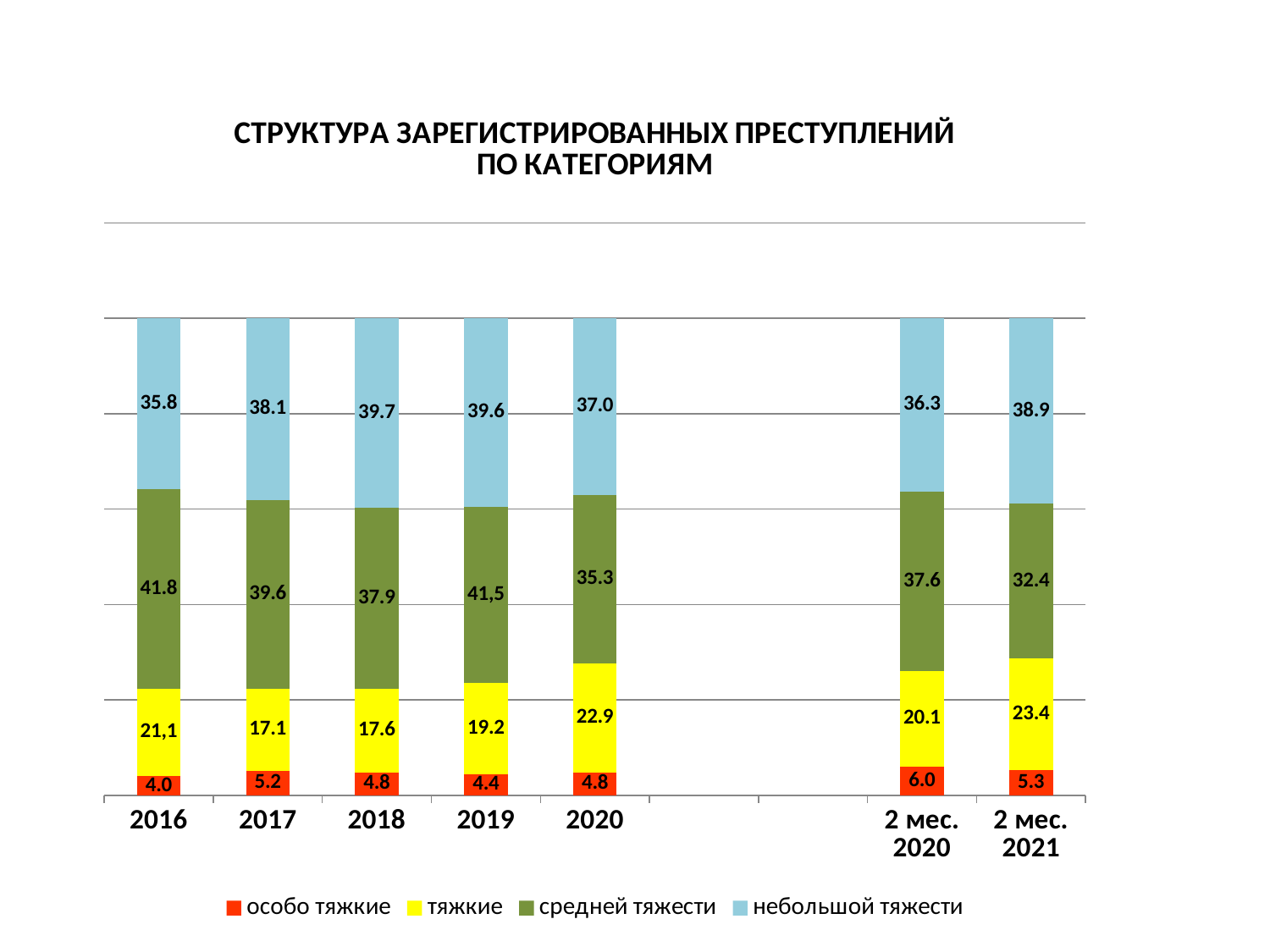
What is the value for тяжкие in 2020? 22.9 What is the value for средней тяжести in 2019? 41,5 In which category is the value for особо тяжкие highest? 2 мес. 2020 Do the values for тяжкие rise or fall from 2017 to 2020? Rise Which is larger, the особо тяжкие value for 2017 or for 2019? 2017 What is the value for небольшой тяжести in 2 мес. 2021? 38.9 How many series does the legend list? 4 How many categories are shown on the x axis? 7 What kind of chart is shown on the slide? Stacked bar chart What is the difference between the тяжкие values for 2020 and 2017? 5.8 In which category is the value for средней тяжести lowest? 2 мес. 2021 In which category is the value for тяжкие lowest? 2017